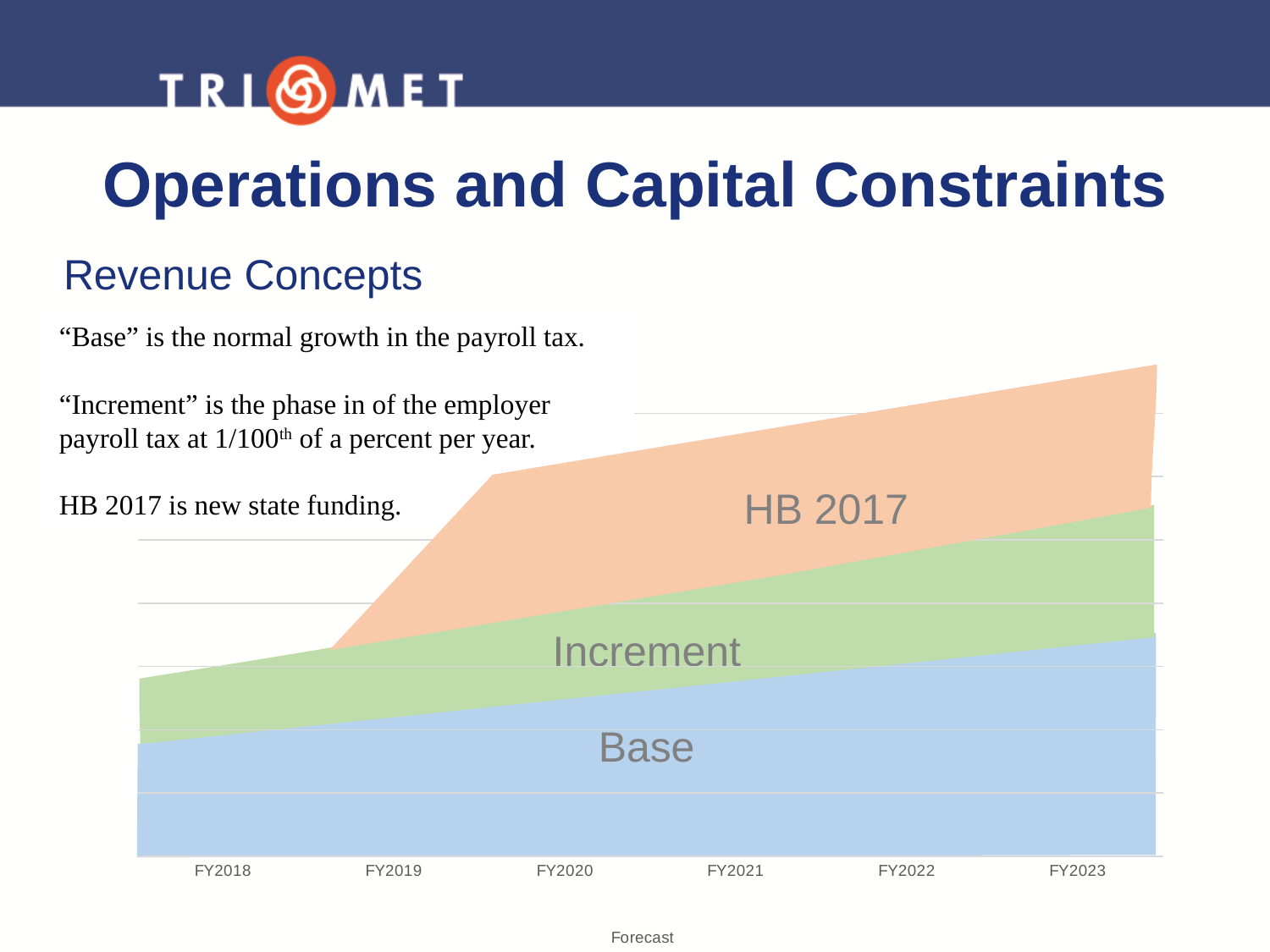
How many series (areas) are plotted in the chart? 3 Which series has no contribution at FY2018 and only begins after FY2018? HB 2017 How many fiscal years are shown along the x axis of the chart? 6 What kind of chart is shown on the slide? Stacked area chart Does the Base series rise or fall across the fiscal years shown? Rise What is the title printed below the x axis of the chart? Forecast Which series is labeled in the middle layer of the stacked area chart? Increment What is the first fiscal year shown on the x axis of the chart? FY2018 Which series forms the bottom layer of the stacked area chart? Base What is the last fiscal year shown on the x axis of the chart? FY2023 Which series forms the top layer of the stacked area chart? HB 2017 Does the total stacked revenue rise or fall from FY2018 to FY2023? Rise